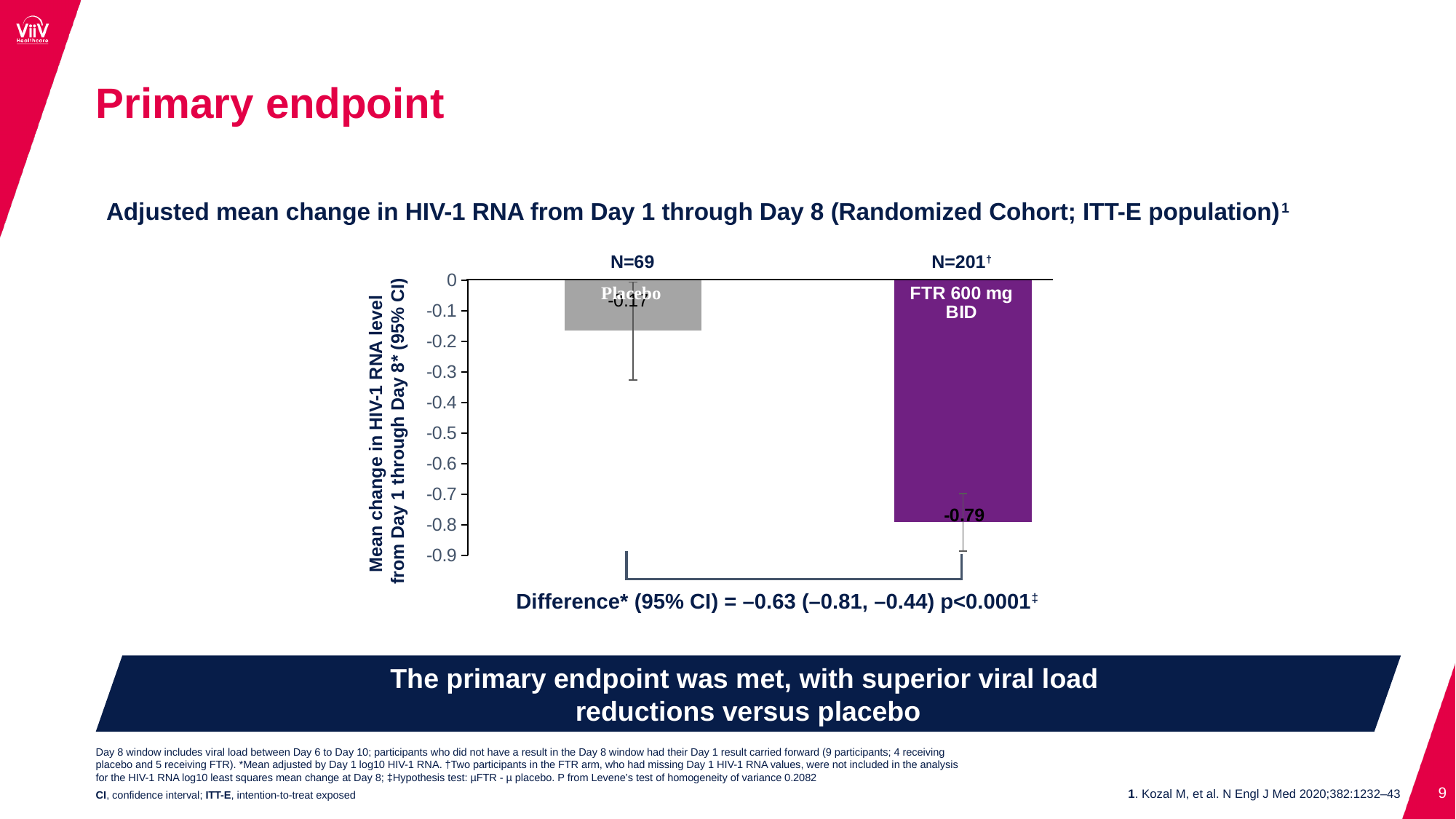
Which group has the mean change closest to zero? Placebo How many participants (N) are in the FTR 600 mg BID group? N=201 What kind of chart is shown on the slide? bar chart What is the adjusted mean change in HIV-1 RNA for the FTR 600 mg BID group? -0.79 What is the difference (95% CI) between groups stated below the chart? –0.63 (–0.81, –0.44) What is the adjusted mean change in HIV-1 RNA for the Placebo group? -0.17 Is the mean change for the FTR 600 mg BID group greater or less than -0.5? less Which group shows the larger reduction (more negative mean change) in HIV-1 RNA? FTR 600 mg BID How many treatment groups (bars) are plotted in the chart? 2 Is the mean change for the Placebo group greater or less than -0.3? greater How many participants (N) are in the Placebo group? N=69 What is the title of the chart? Adjusted mean change in HIV-1 RNA from Day 1 through Day 8 (Randomized Cohort; ITT-E population)